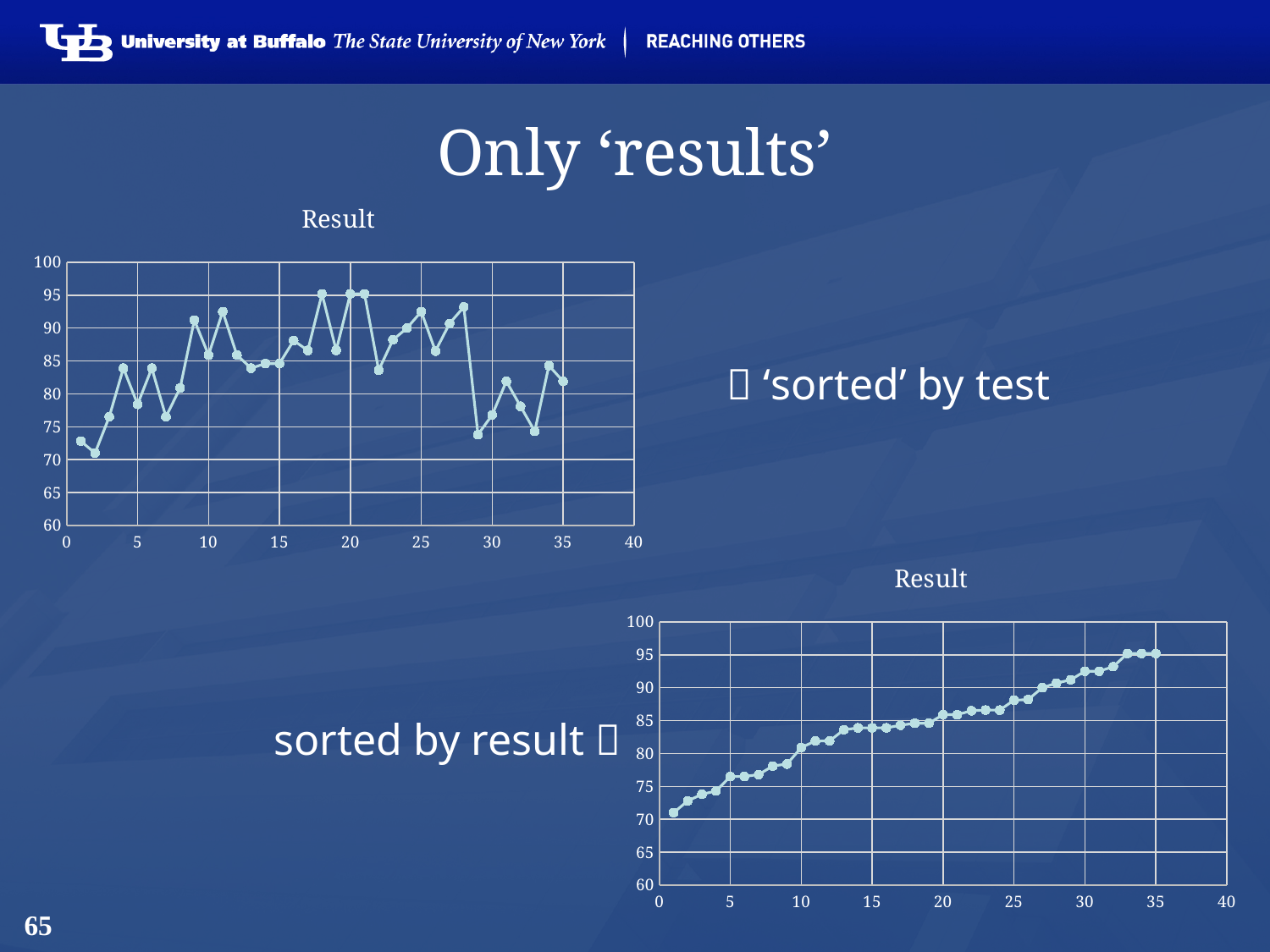
What type of chart is the top-left chart titled 'Result'? line chart In the bottom-right chart, which has the larger value, the point at x = 10 or the point at x = 30? x = 30 In the top-left chart, is the value at x = 20 greater or less than 90? greater In the bottom-right chart, is the value at x = 25 greater or less than 90? less In the top-left chart, at which x value is the lowest point? 2 In the bottom-right chart, is the value at x = 1 greater or less than 75? less In the top-left chart, which has the larger value, the point at x = 9 or the point at x = 10? x = 9 What is the title of the bottom-right chart? Result In the bottom-right chart, do the values rise or fall as the x axis increases? rise